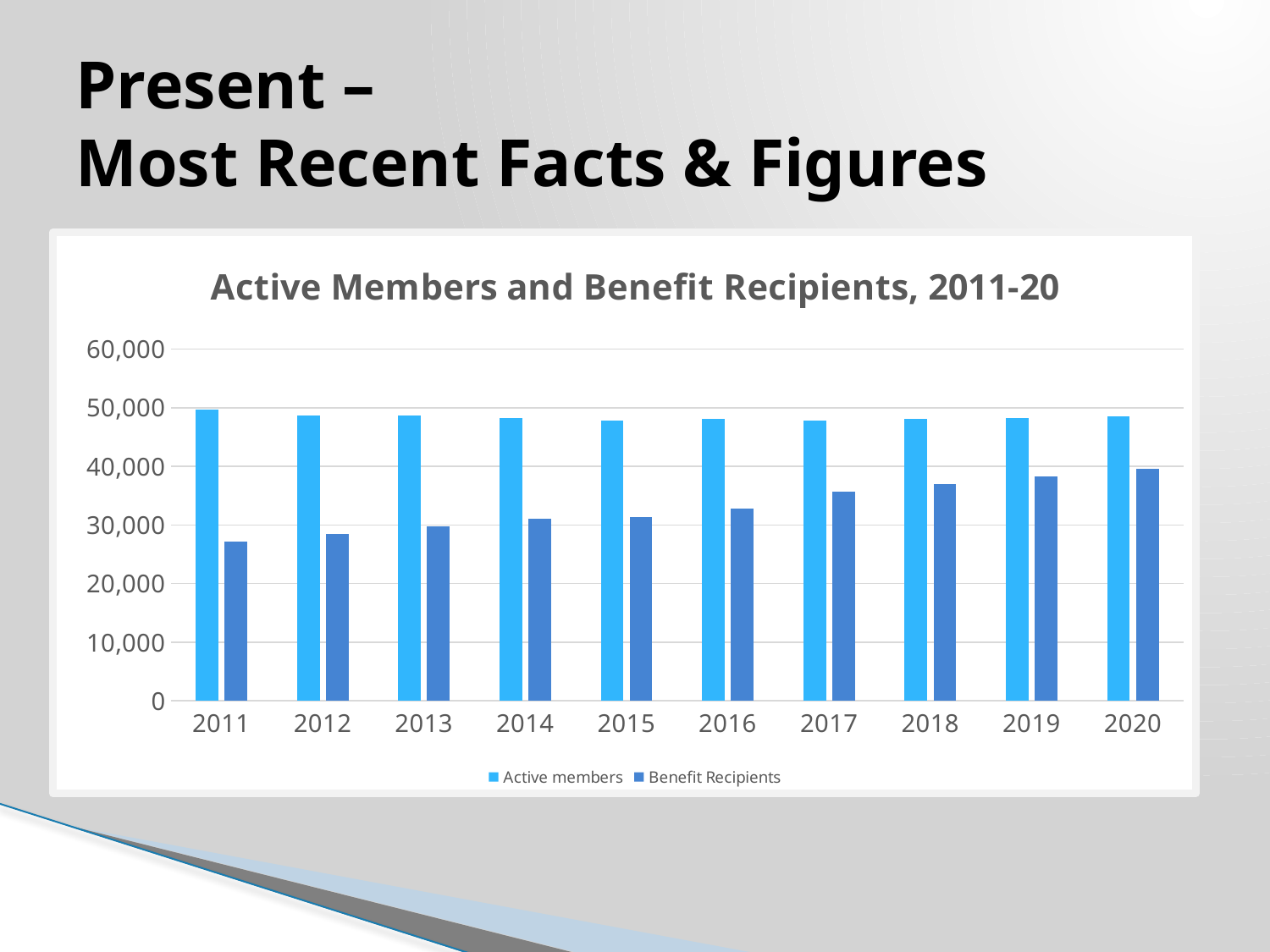
Do the Benefit Recipients values rise or fall from 2011 to 2020? rise Is the value for Active members in 2020 greater or less than 60,000? less Is the value for Active members in 2011 greater or less than 40,000? greater Which year has the lowest value for Benefit Recipients? 2011 What kind of chart is shown on the slide? bar chart In 2020, which is larger: Active members or Benefit Recipients? Active members Is the value for Benefit Recipients in 2011 greater or less than 30,000? less Which year has the highest value for Benefit Recipients? 2020 How many years are shown on the x axis? 10 What is the title of the chart? Active Members and Benefit Recipients, 2011-20 How many series does the legend list? 2